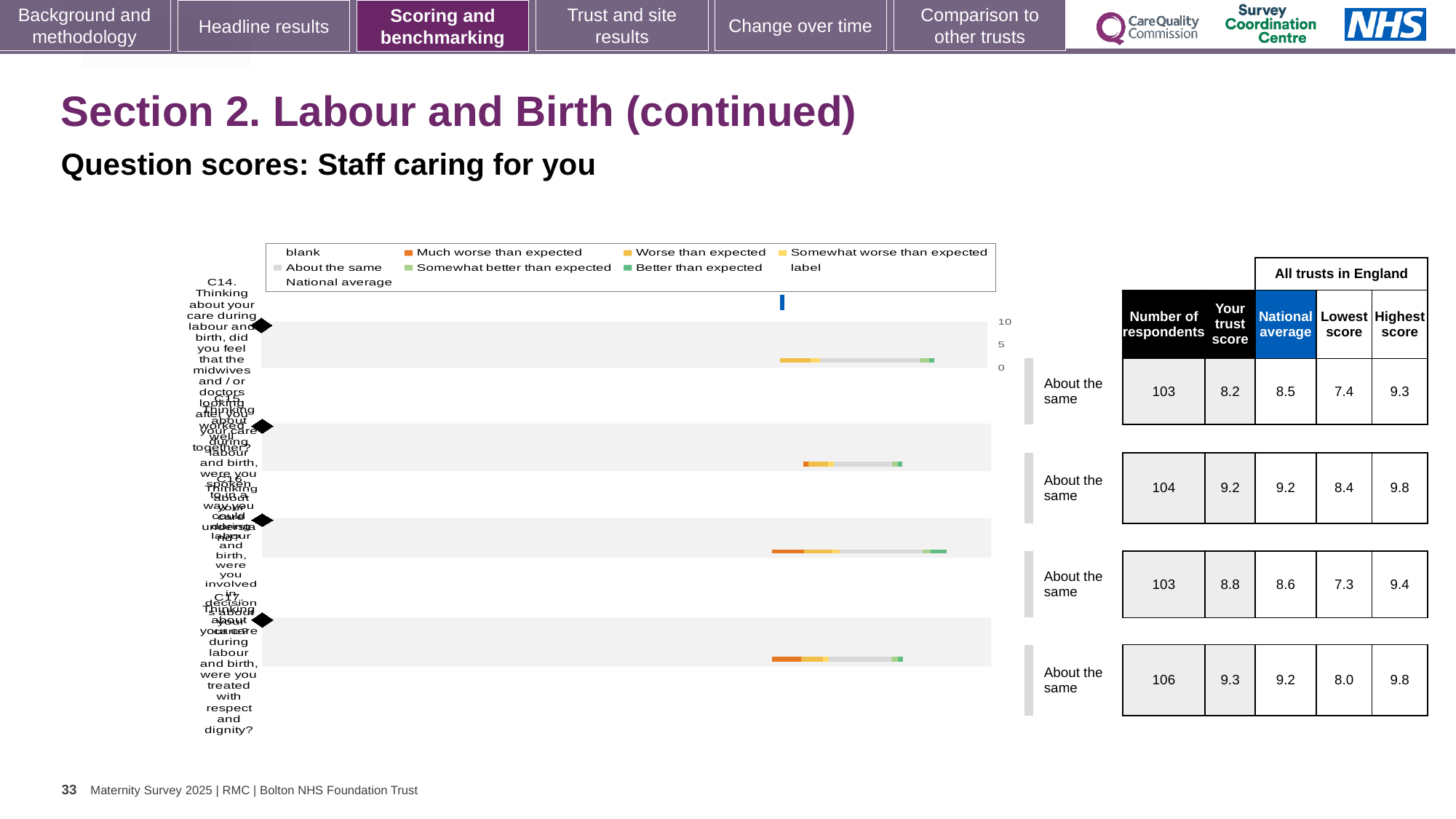
For the first row (C14), what is the difference between the national average and the trust score? 0.3 What is the highest score among all trusts in England for the second row (C15)? 9.8 How many question rows (bars) does the chart show? 4 What is the lowest score among all trusts in England for the last row (C17)? 8.0 In the chart legend, what colour represents 'Much worse than expected'? orange What kind of chart is shown on the slide? bar chart For the third row (C16), which is larger: the trust score or the national average? the trust score (8.8) What is the 'Your trust score' for the first row, C14 (midwives and/or doctors worked well together)? 8.2 What benchmark label is shown next to each of the four rows? About the same What is the number of respondents for the last row, C17 (treated with respect and dignity)? 106 Which row has the highest 'Your trust score'? C17 (last row), 9.3 Which row has the lowest 'Your trust score'? C14 (first row), 8.2